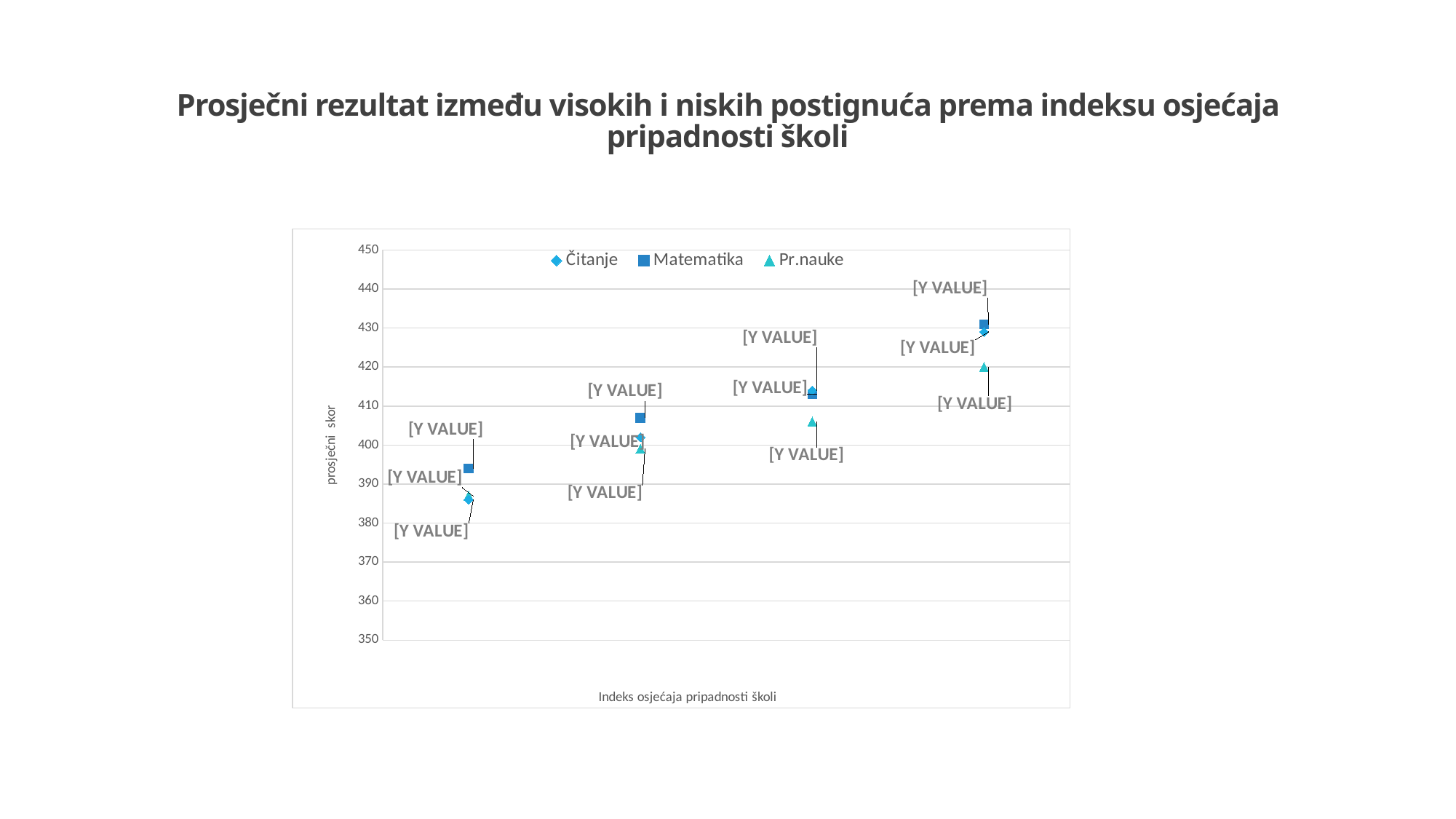
Which series are listed in the legend? Čitanje, Matematika, Pr.nauke Is the rightmost Matematika point greater or less than 420? greater Is the rightmost Pr.nauke point greater or less than 430? less How many data points are plotted for the Matematika series? 4 What is the title of the vertical axis? prosječni skor Is the leftmost Čitanje point greater or less than 390? less What kind of chart is shown on the slide? Scatter chart Do the scores rise or fall from left to right along the x axis? Rise At the rightmost position on the x axis, which series has the higher value, Matematika or Pr.nauke? Matematika How many series does the legend list? 3 Which series contains the highest plotted point on the chart? Matematika